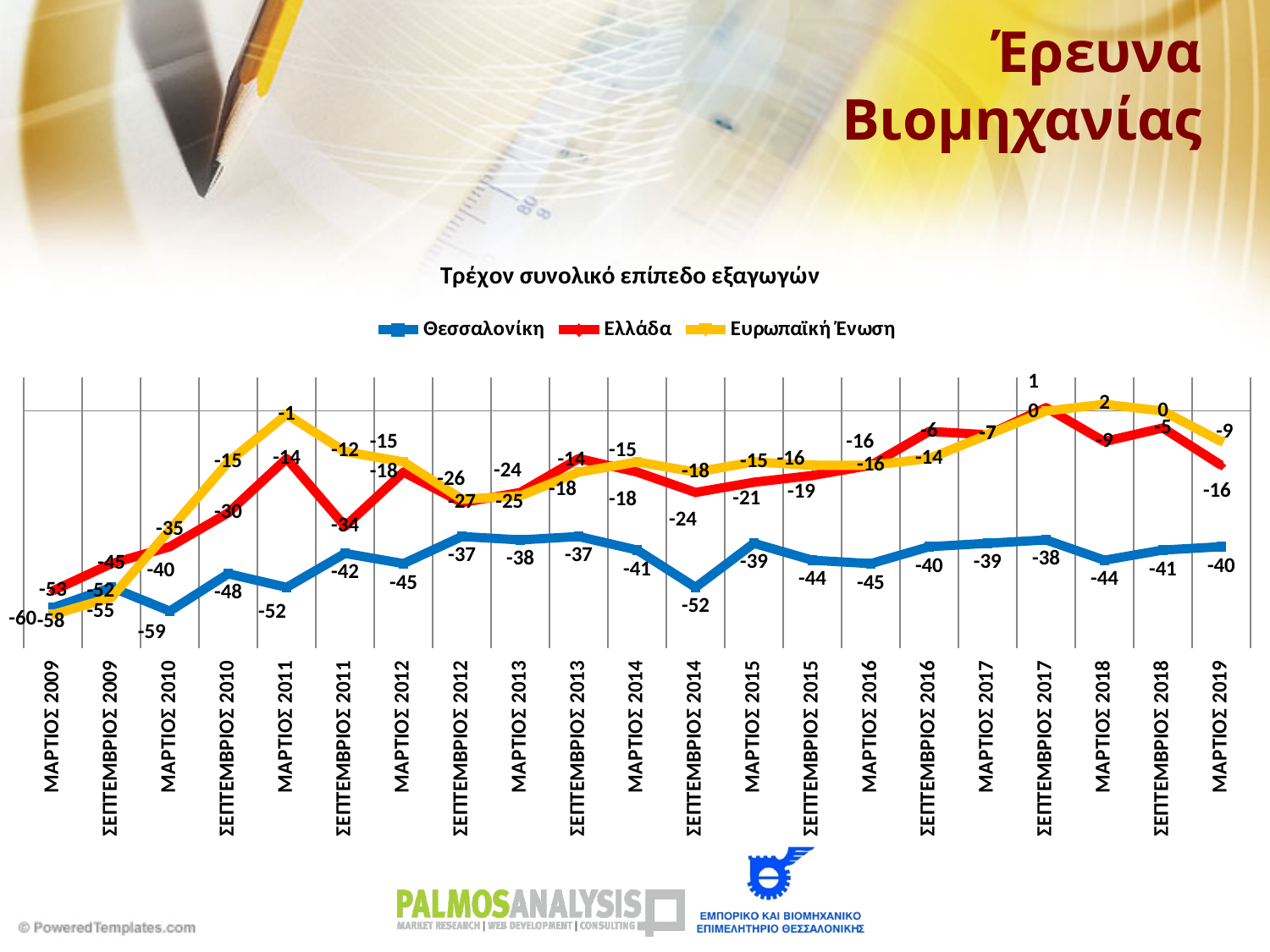
What is the value for Θεσσαλονίκη in ΜΑΡΤΙΟΣ 2010? -59 In ΜΑΡΤΙΟΣ 2011, which series has the higher value, Ελλάδα or Ευρωπαϊκή Ένωση? Ευρωπαϊκή Ένωση What kind of chart is shown on the slide? line chart How many series does the legend list? 3 What is the value for Θεσσαλονίκη in ΜΑΡΤΙΟΣ 2019? -40 What is the value for Ελλάδα in ΜΑΡΤΙΟΣ 2019? -16 At which time point does Ευρωπαϊκή Ένωση reach its highest value? ΜΑΡΤΙΟΣ 2018 What is the difference between the Ελλάδα and Θεσσαλονίκη values in ΜΑΡΤΙΟΣ 2019? 24 What colour is the Ελλάδα line in the chart? red At which time point does Θεσσαλονίκη have its lowest value? ΜΑΡΤΙΟΣ 2010 What is the value for Ευρωπαϊκή Ένωση in ΜΑΡΤΙΟΣ 2018? 2 How many time points are plotted along the x axis? 21